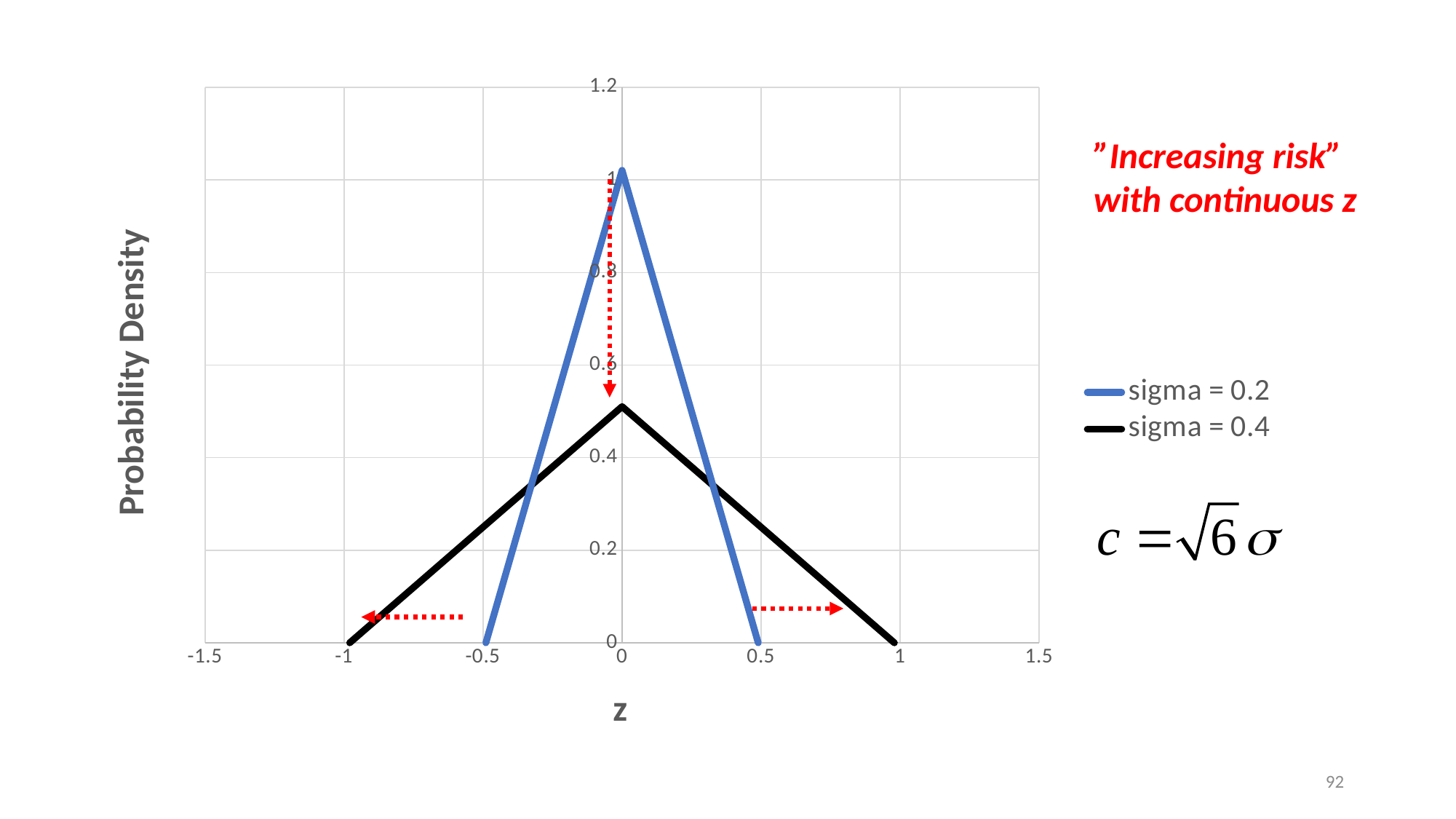
What kind of chart is shown on the slide? line chart At z = 0, which series has the higher probability density? sigma = 0.2 What are the two series named in the legend? sigma = 0.2 and sigma = 0.4 What is the title of the vertical axis? Probability Density Does the sigma = 0.2 series rise or fall as z increases from 0 to 0.5? fall Is the probability density of the sigma = 0.4 series at z = 0 greater or less than 0.6? less How many series does the legend list? 2 At z = 0.5, which series has the higher probability density? sigma = 0.4 Is the probability density of the sigma = 0.4 series at z = 0 greater or less than 0.4? greater